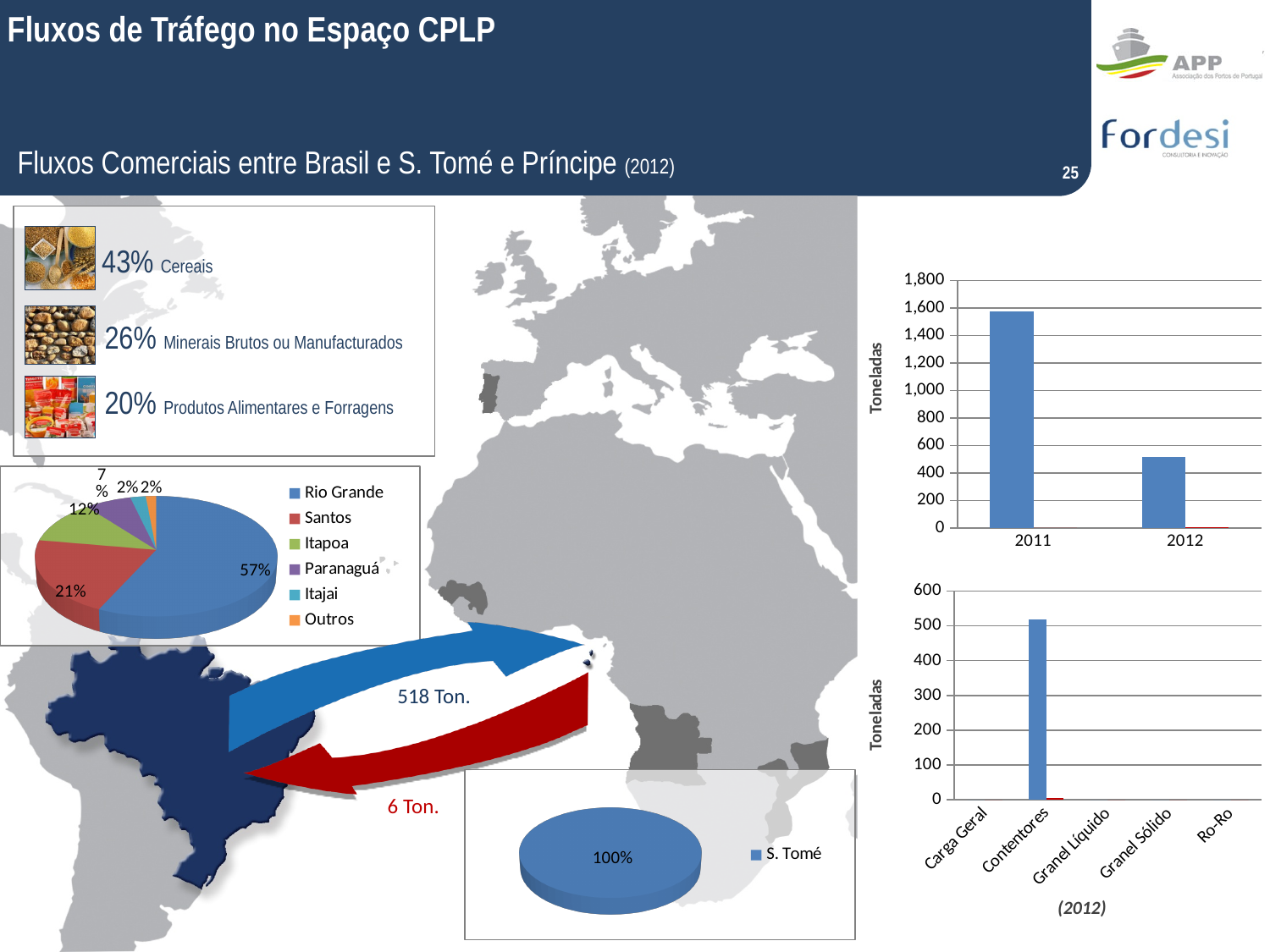
In the pie chart on the left with the legend Rio Grande, Santos, Itapoa, Paranaguá, Itajai and Outros, what share does Santos have? 21% In the bar chart at the top right with years on the x axis, do the values rise or fall from 2011 to 2012? fall In the pie chart on the left with the legend Rio Grande, Santos, Itapoa, Paranaguá, Itajai and Outros, which port has the largest slice? Rio Grande In the bar chart at the bottom right with cargo types on the x axis, which category has the highest value? Contentores In the bar chart at the top right with years on the x axis, is the value for 2011 greater or less than 1,400? greater In the bar chart at the bottom right with cargo types on the x axis, how many categories are shown? 5 In the pie chart on the left with the legend Rio Grande, Santos, Itapoa, Paranaguá, Itajai and Outros, what share does Itapoa have? 12% In the pie chart on the left with the legend Rio Grande, Santos, Itapoa, Paranaguá, Itajai and Outros, how many entries does the legend list? 6 In the bar chart at the top right with years on the x axis, is the value for 2012 greater or less than 600? less In the pie chart on the left with the legend Rio Grande, Santos, Itapoa, Paranaguá, Itajai and Outros, what share does Rio Grande have? 57% In the pie chart on the left with the legend Rio Grande, Santos, Itapoa, Paranaguá, Itajai and Outros, what is the difference between the Rio Grande and Santos shares? 36%